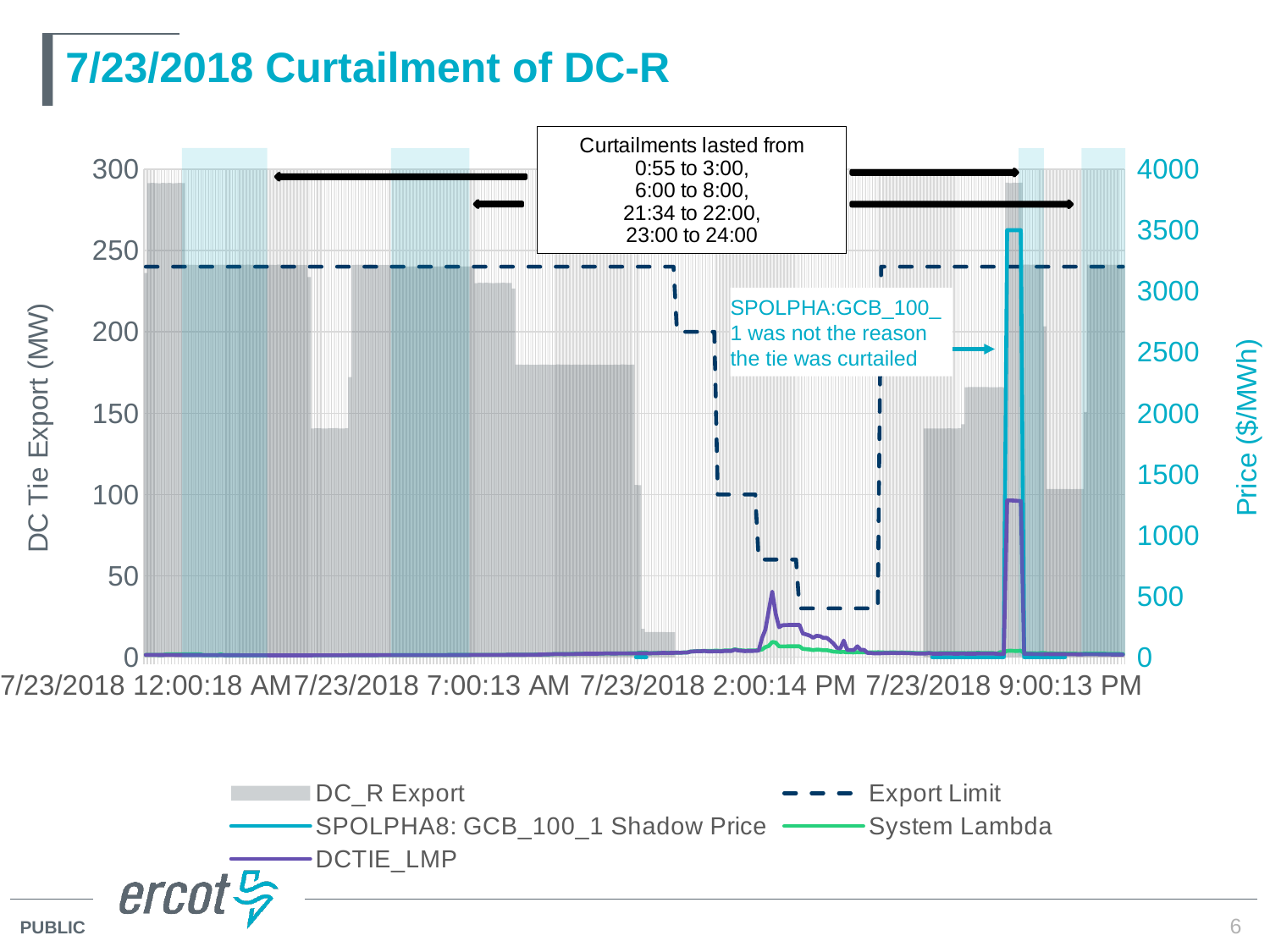
Is the Export Limit at its lowest point in the afternoon greater or less than 50 MW? less Is the peak of DCTIE_LMP greater or less than 1000 $/MWh? greater Is the System Lambda at 2:00 PM greater or less than 500 $/MWh? less What is the label of the left vertical axis? DC Tie Export (MW) How many series does the chart legend list? 5 What kind of chart is shown on the slide? A combination bar and line chart Which series reaches a higher peak price, SPOLPHA8: GCB_100_1 Shadow Price or DCTIE_LMP? SPOLPHA8: GCB_100_1 Shadow Price What is the title of the chart slide? 7/23/2018 Curtailment of DC-R Does the Export Limit rise or fall between 7:00 AM and 2:00 PM? fall